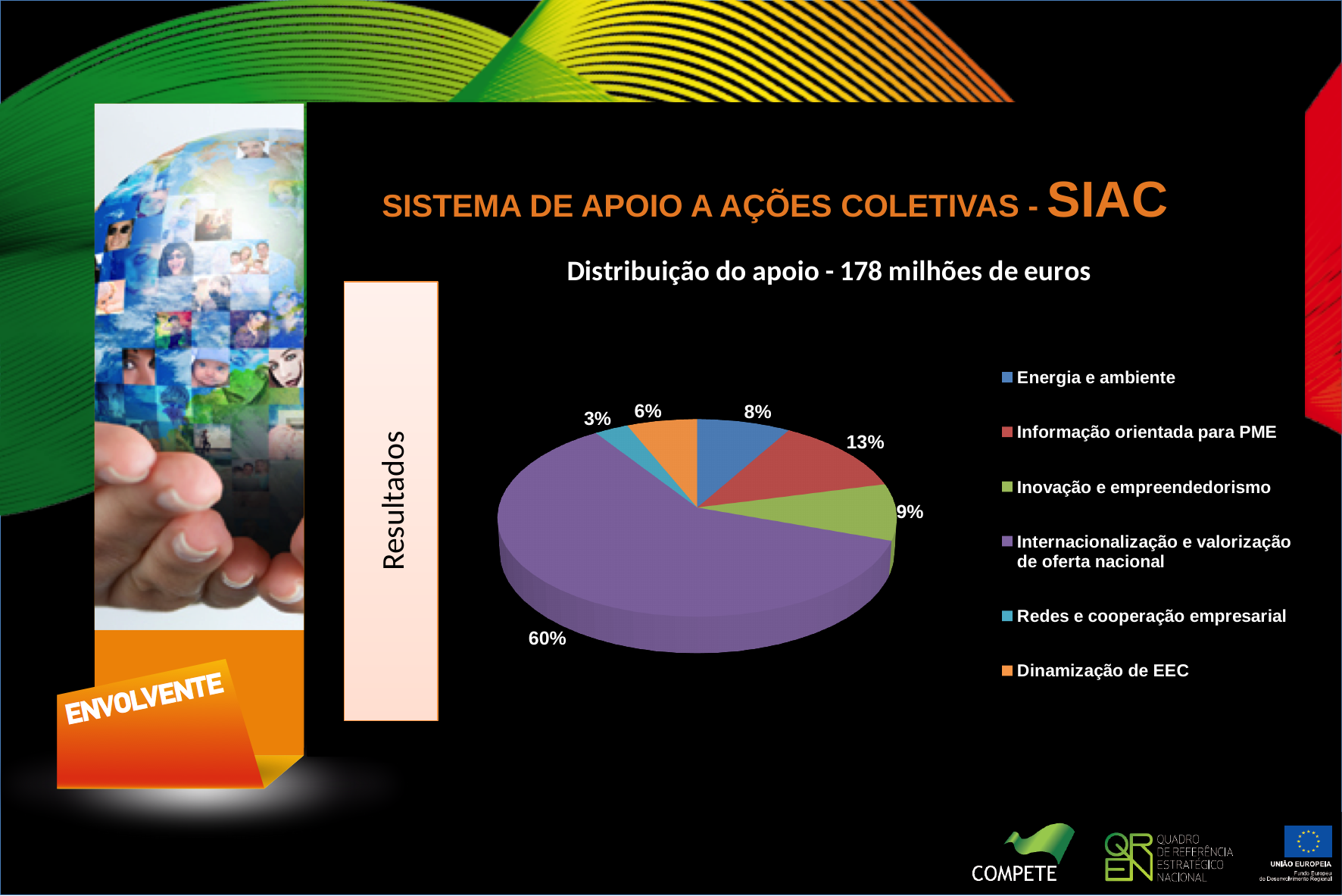
What share of the pie does Energia e ambiente have? 8% What share of the pie does Internacionalização e valorização de oferta nacional have? 60% What share of the pie does Dinamização de EEC have? 6% Which category has the smallest slice of the pie? Redes e cooperação empresarial What is the title of the chart? Distribuição do apoio - 178 milhões de euros What kind of chart is shown on the slide? Pie chart How many categories does the legend list? 6 Which is larger, the share for Energia e ambiente or the share for Dinamização de EEC? Energia e ambiente What is the difference in percentage points between Informação orientada para PME and Inovação e empreendedorismo? 4 Which category has the largest slice of the pie? Internacionalização e valorização de oferta nacional